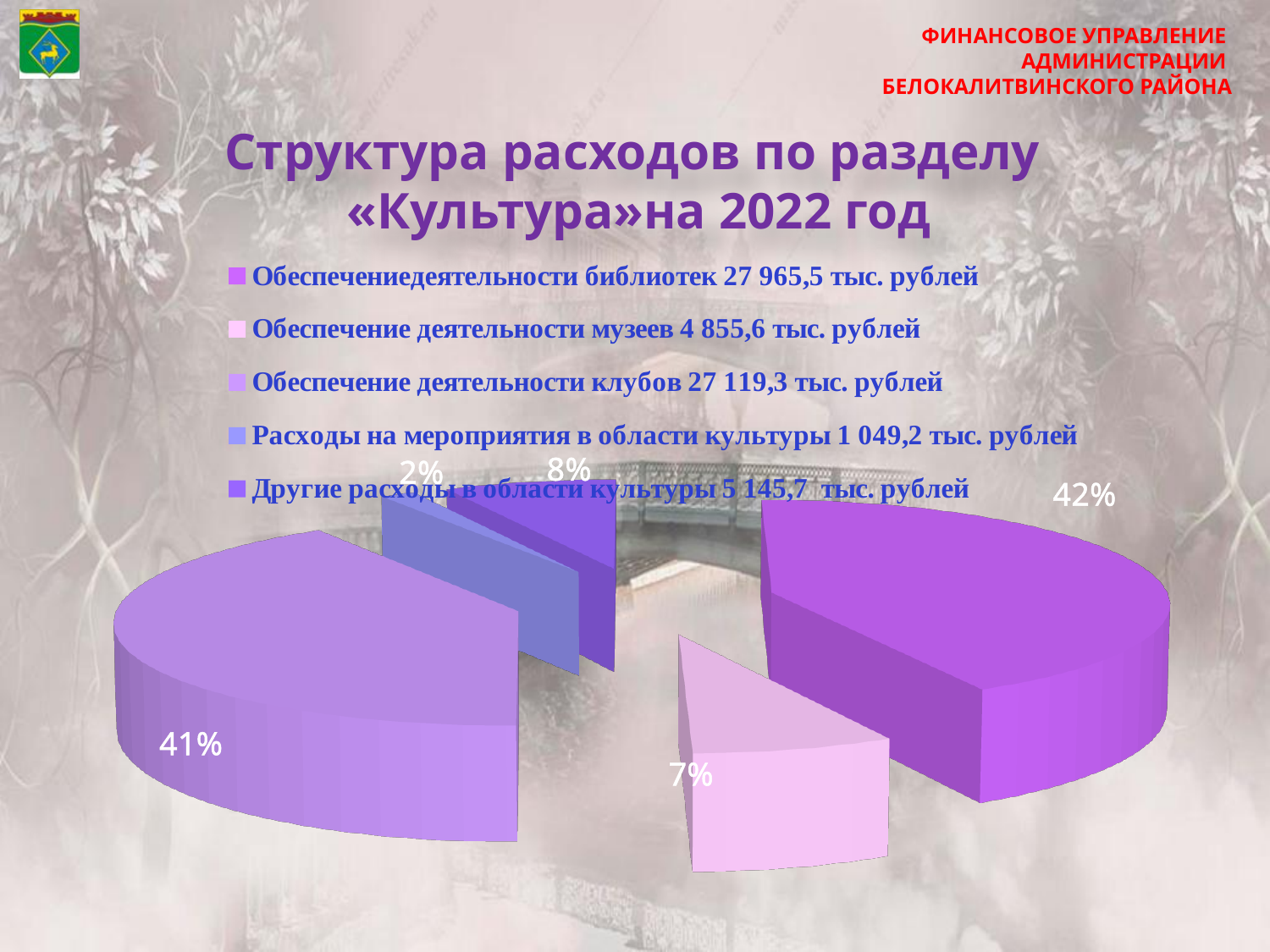
What share of the pie is labelled for «Расходы на мероприятия в области культуры»? 2% What share of the pie is labelled for «Обеспечение деятельности клубов»? 41% Which slice is larger: «Обеспечение деятельности музеев» or «Другие расходы в области культуры»? Другие расходы в области культуры What amount does the legend give for «Обеспечение деятельности клубов»? 27 119,3 тыс. рублей Which category has the largest share of the pie? Обеспечение деятельности библиотек What kind of chart is shown on the slide? pie chart What share of the pie is labelled for «Обеспечение деятельности музеев»? 7% Which category has the smallest share of the pie? Расходы на мероприятия в области культуры How many slices does the pie chart have? 5 What is the difference in percentage points between the libraries slice and the museums slice? 35